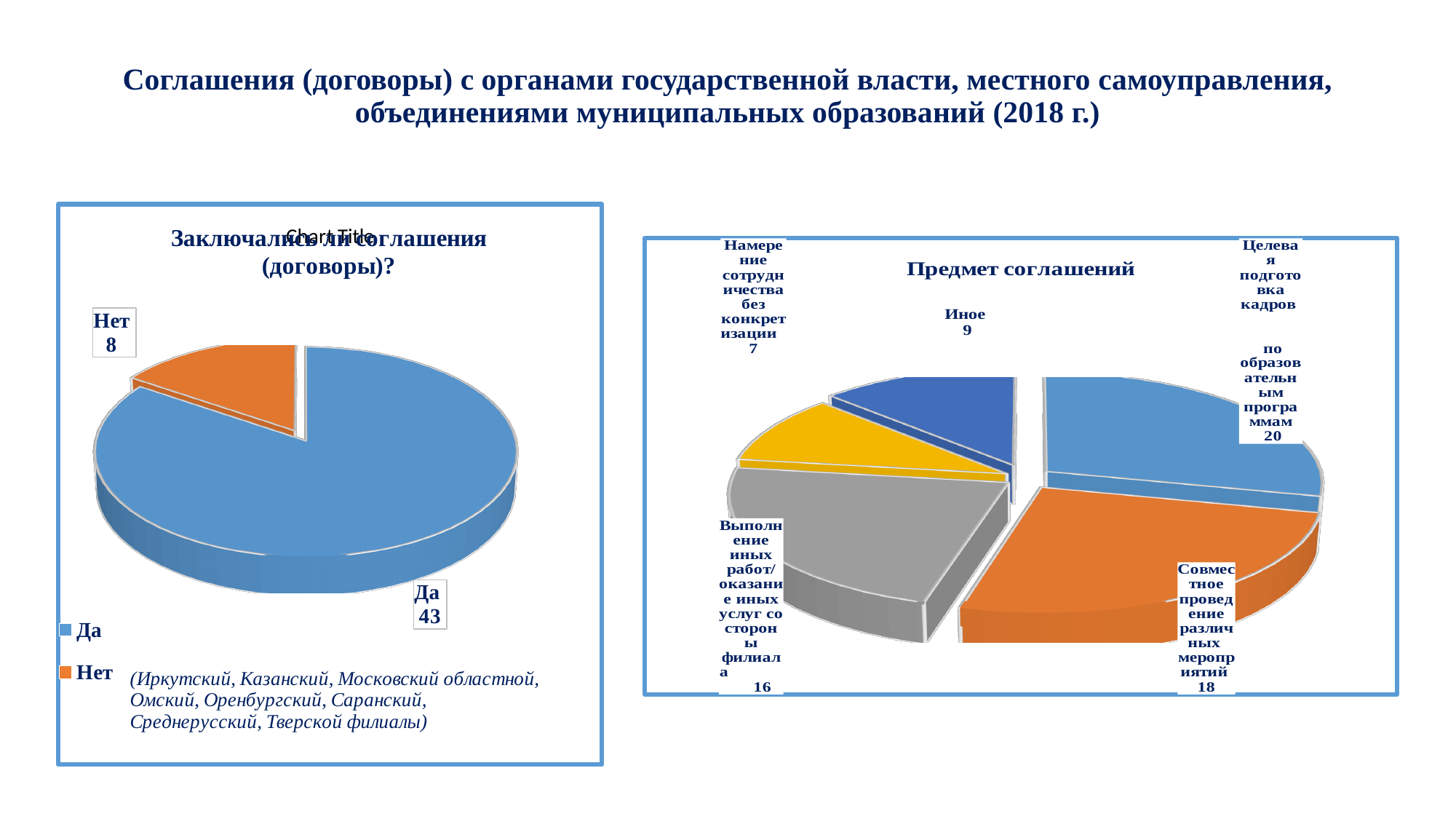
In the right chart 'Предмет соглашений', how many categories are shown? 5 In the right chart 'Предмет соглашений', what is the value for 'Совместное проведение различных мероприятий'? 18 In the right chart 'Предмет соглашений', what is the total of all slices? 70 In the left chart 'Заключались ли соглашения (договоры)?', what is the total of all slices? 51 In the left chart 'Заключались ли соглашения (договоры)?', what is the value for 'Нет'? 8 In the right chart 'Предмет соглашений', which category has the lowest value? Намерение сотрудничества без конкретизации In the left chart 'Заключались ли соглашения (договоры)?', what is the difference between the 'Да' and 'Нет' values? 35 In the right chart 'Предмет соглашений', what is the difference between 'Целевая подготовка кадров по образовательным программам' and 'Выполнение иных работ/оказание иных услуг со стороны филиала'? 4 In the left chart 'Заключались ли соглашения (договоры)?', what is the value for 'Да'? 43 In the right chart 'Предмет соглашений', which category has the highest value? Целевая подготовка кадров по образовательным программам In the right chart 'Предмет соглашений', what is the value for 'Иное'? 9 What type of chart is the left chart 'Заключались ли соглашения (договоры)?'? Pie chart